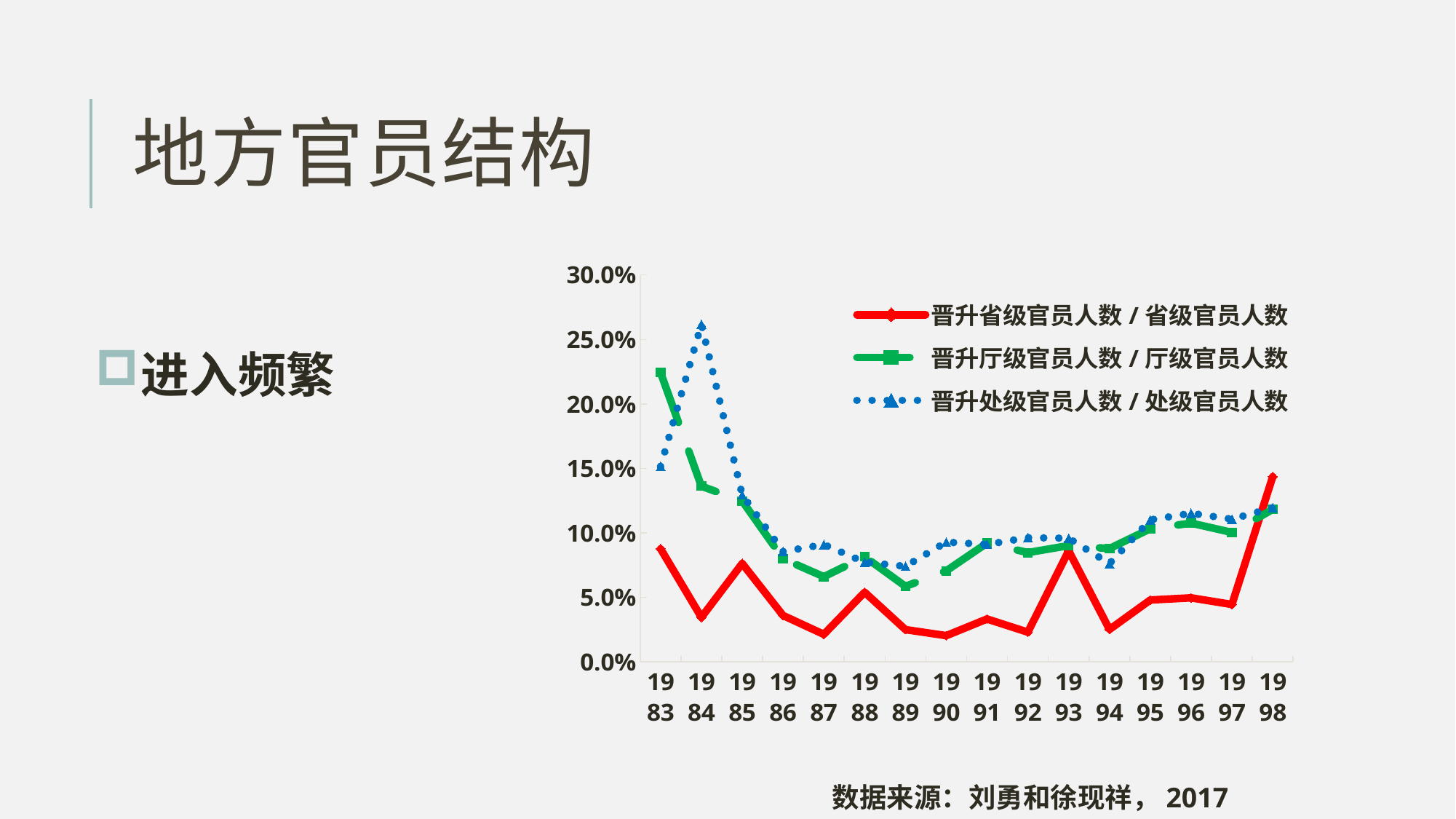
Does the 晋升厅级官员人数 / 厅级官员人数 series rise or fall from 1983 to 1987? fall Is the value for 晋升省级官员人数 / 省级官员人数 in 1987 greater or less than 5.0%? less Which year has the highest value for the 晋升处级官员人数 / 处级官员人数 series? 1984 Which series is drawn with the solid red line? 晋升省级官员人数 / 省级官员人数 How many years are shown on the x axis of the chart? 16 Is the value for 晋升厅级官员人数 / 厅级官员人数 in 1983 greater or less than 20.0%? greater Is the value for 晋升处级官员人数 / 处级官员人数 in 1984 greater or less than 25.0%? greater What kind of chart is shown on the slide? line chart Which year has the highest value for the 晋升省级官员人数 / 省级官员人数 series? 1998 Which year has the highest value for the 晋升厅级官员人数 / 厅级官员人数 series? 1983 In 1983, which series has the larger value: 晋升厅级官员人数 / 厅级官员人数 or 晋升省级官员人数 / 省级官员人数? 晋升厅级官员人数 / 厅级官员人数 How many series does the legend list? 3